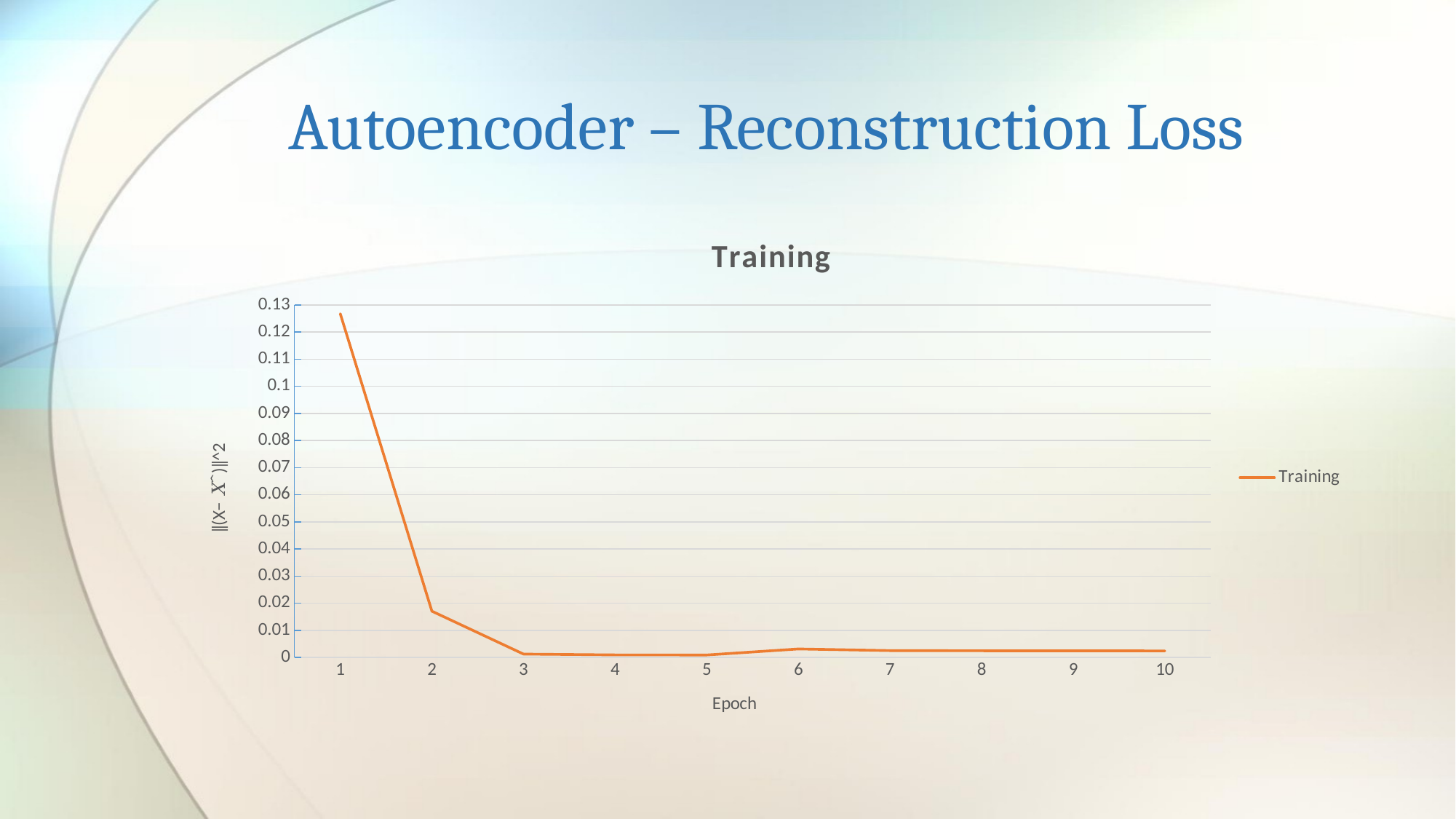
Is the value at epoch 1 greater or less than 0.12? greater Is the value at epoch 10 greater or less than 0.01? less Is the value at epoch 2 greater or less than 0.02? less What is the label of the x axis? Epoch How many epochs are plotted on the x axis? 10 What is the title of the chart? Training At which epoch is the training loss highest? 1 What kind of chart is shown on the slide? line chart Does the training loss generally rise or fall from epoch 1 to epoch 10? fall How many series does the legend list? 1 Which is larger, the value at epoch 1 or the value at epoch 2? epoch 1